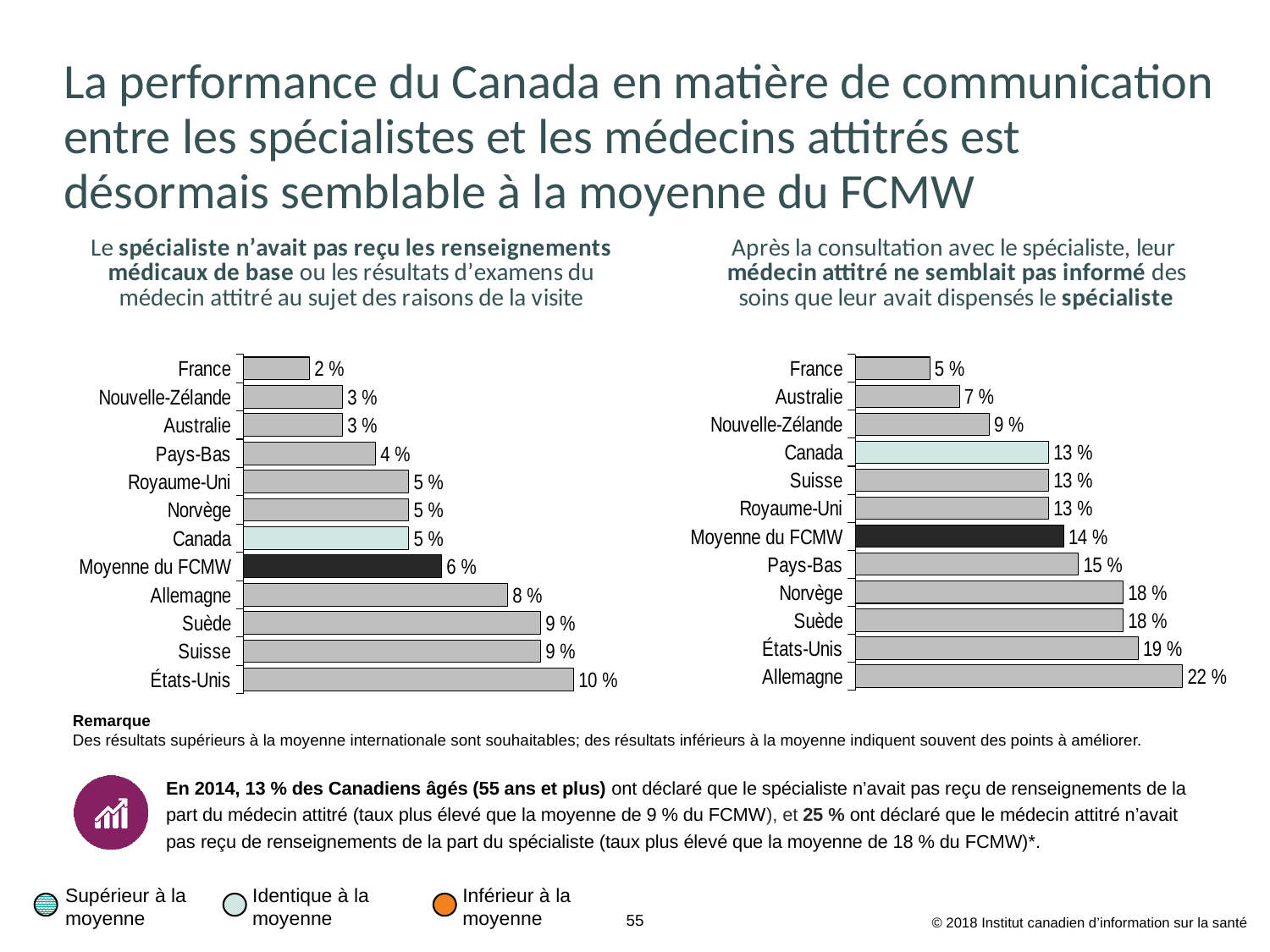
What type of chart is the left chart? Bar chart In the left chart, which country has the highest value? États-Unis In the right chart, which country has the highest value? Allemagne In the left chart, what is the difference between États-Unis and Canada? 5 % In the left chart, what is the value for Moyenne du FCMW? 6 % In the right chart, what is the value for Moyenne du FCMW? 14 % In the left chart, which country has the lowest value? France In the right chart, what is the value for Canada? 13 % In the right chart, which is larger, the value for Pays-Bas or the value for Australie? Pays-Bas In the left chart, what is the value for Canada? 5 % In the right chart, what is the difference between Allemagne and France? 17 % How many countries or categories are shown in the right chart? 12